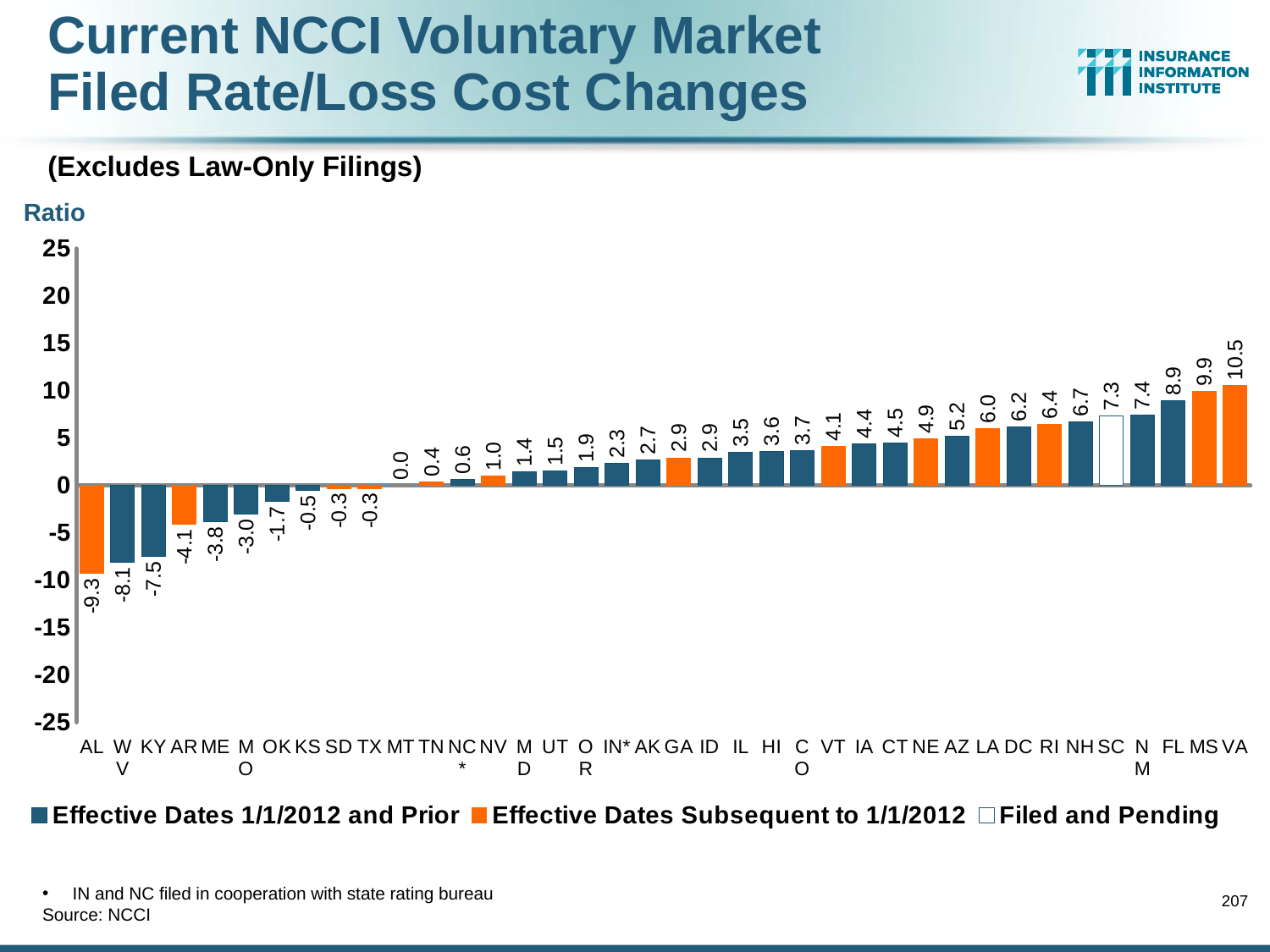
What is the value for MT? 0.0 Is the value for KY greater or less than -5? less Which state has the highest value? VA What is the value for VA? 10.5 How many series does the legend list? 3 What kind of chart is this? bar chart Which state has the lowest value? AL Which state's bar is shown as Filed and Pending? SC What is the difference between the values for VA and AL? 19.8 Which has a larger value, FL or MS? MS What is the value for AL? -9.3 How many states are shown on the chart? 38